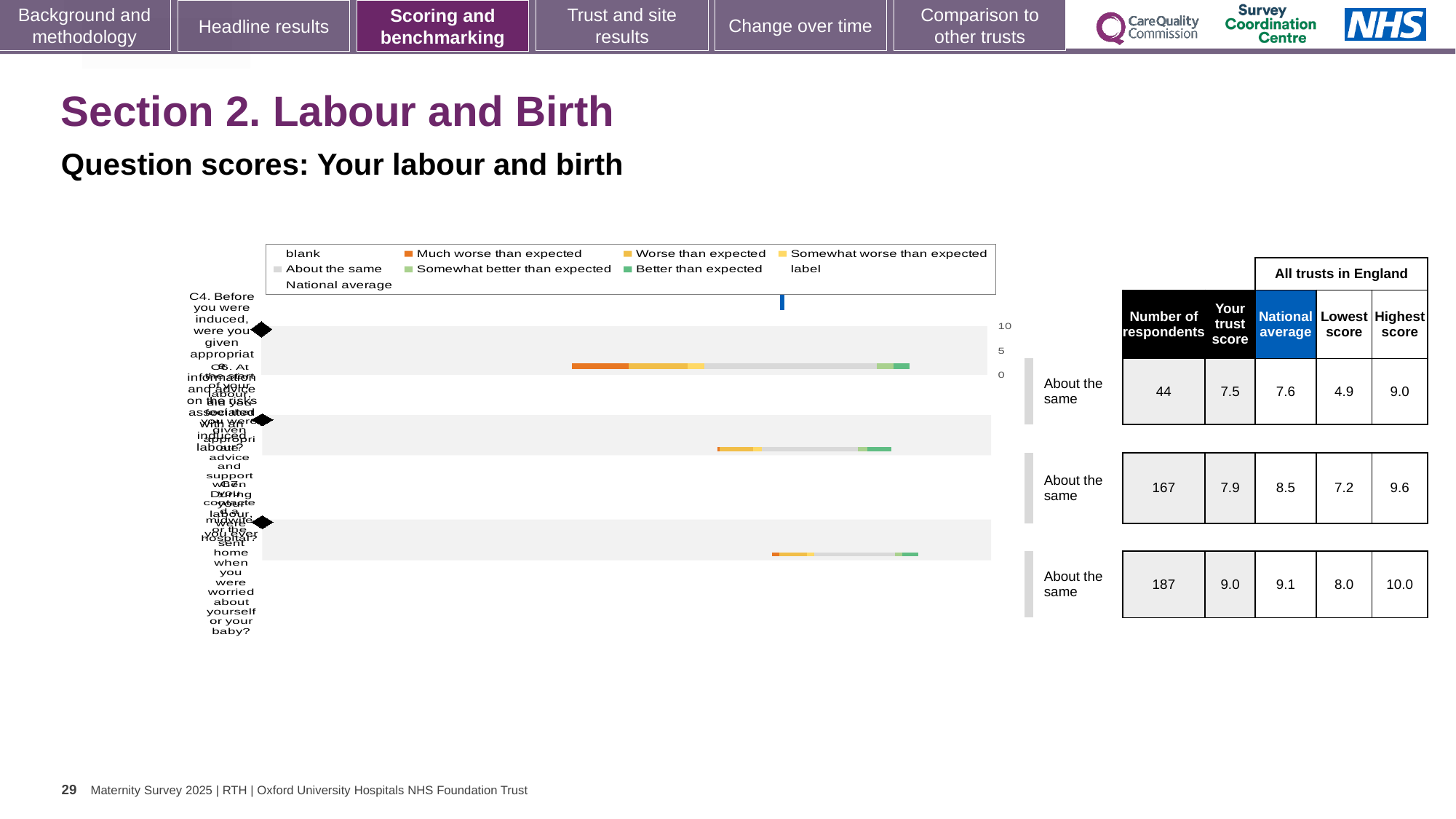
How many horizontal bars are plotted in the chart? 3 What is the maximum value shown on the chart's numeric axis? 10 In the table beside the chart, in the second row, which is larger: the trust score or the national average? national average What benchmark label is shown to the right of each of the three bars? About the same In the table beside the chart, what is the 'Your trust score' value in the second row? 7.9 In the table beside the chart, what is the highest score in the third row? 10.0 In the table beside the chart, what is the lowest score in the first row? 4.9 What kind of chart is shown on the slide? bar chart In the table beside the chart, which row has the largest number of respondents? the third row (187) In the table beside the chart, what is the difference between the national average and the trust score in the second row? 0.6 What colour does the legend use for 'Much worse than expected'? orange In the table beside the chart, what is the number of respondents in the first row? 44